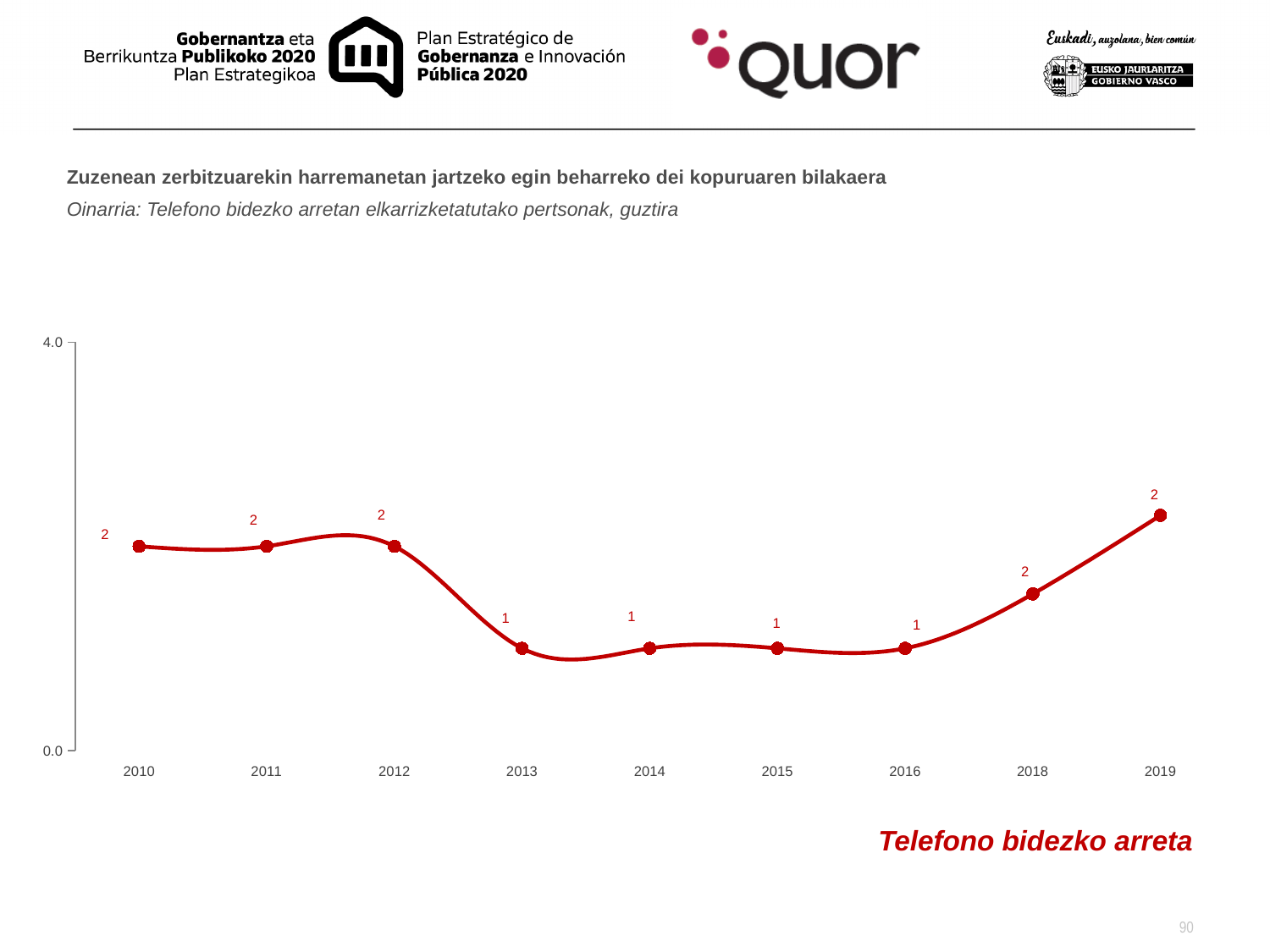
What is the data label for 2018? 2 How many years are plotted on the x axis? 9 What colour is the plotted line? red What is the data label for 2015? 1 What is the difference between the labelled values for 2012 and 2013? 1 Which year has the highest point on the line? 2019 What kind of chart is shown on the slide? line chart What is the data label for 2013? 1 Is the value for 2019 greater or less than 4.0? less What is the data label for 2010? 2 Do the values rise or fall from 2016 to 2019? rise Which is larger, the value for 2012 or the value for 2014? 2012